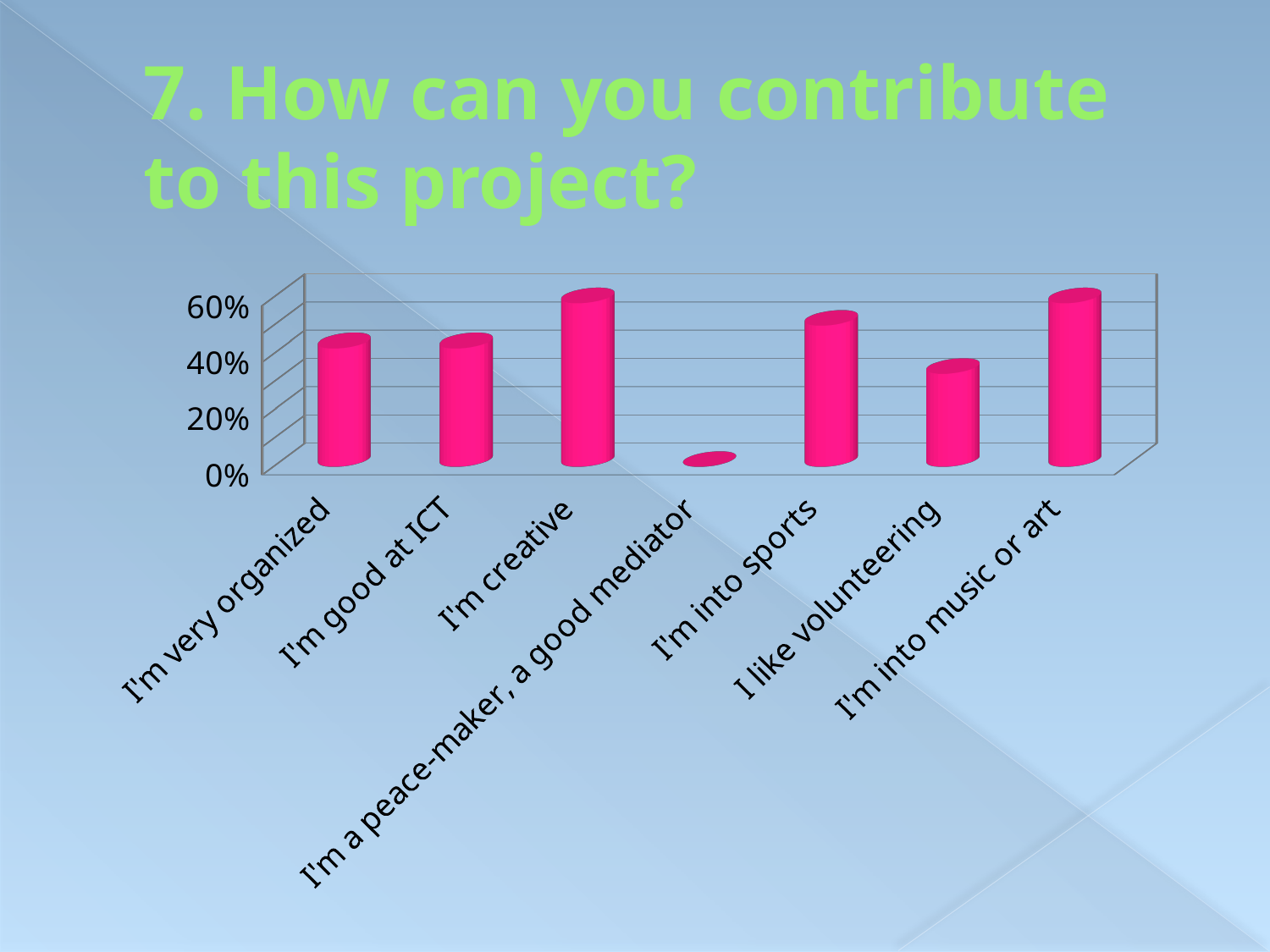
What colour are the bars in the chart? pink How many categories are shown on the x axis of the chart? 7 Is the value for "I'm very organized" greater or less than 60%? less Is the value for "I'm creative" greater or less than 40%? greater What is the value for "I'm a peace-maker, a good mediator"? 0% Is the value for "I like volunteering" greater or less than 40%? less What kind of chart is shown on the slide? bar chart Which is larger, the value for "I'm creative" or the value for "I like volunteering"? I'm creative Which is larger, the value for "I'm into sports" or the value for "I like volunteering"? I'm into sports Which category has the lowest value in the chart? I'm a peace-maker, a good mediator What is the title of the slide containing the chart? 7. How can you contribute to this project?